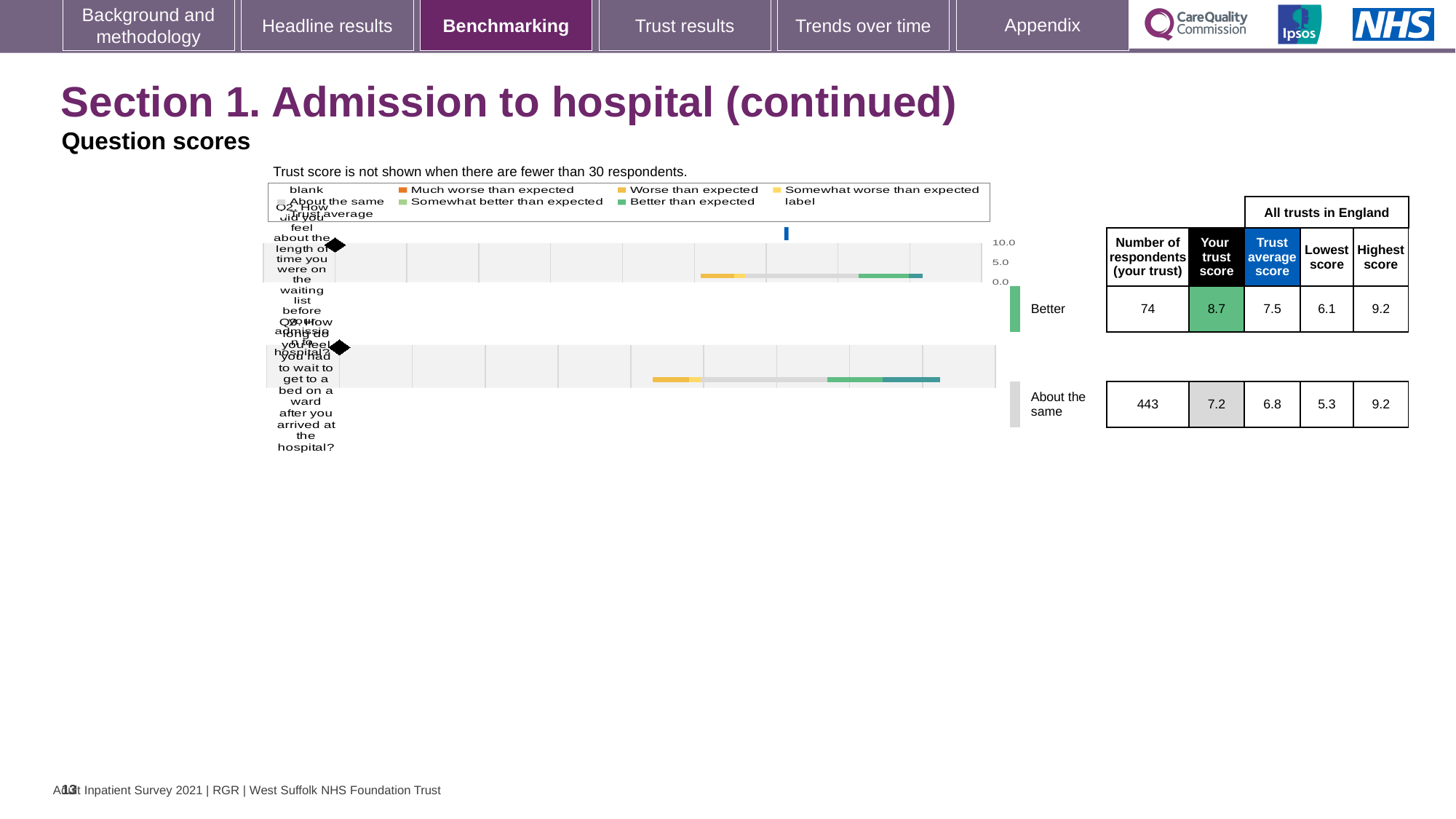
What is the trust score for Q3 (how long did you feel you had to wait to get to a bed on a ward)? 7.2 By how much does the trust score for Q2 exceed the trust average score for Q2? 1.2 What benchmark category is shown for Q3? About the same What kind of chart is used to show the question scores on this slide? bar chart What is the trust score for Q2 (how did you feel about the length of time on the waiting list)? 8.7 What is the lowest score across all trusts in England for Q3? 5.3 How many respondents answered Q3 for this trust? 443 In the legend, which colour represents 'Much worse than expected'? Orange What is the trust average score for Q2? 7.5 Which question has the higher trust score, Q2 or Q3? Q2 How many questions are plotted in the question scores charts on this slide? 2 How many respondents answered Q2 for this trust? 74